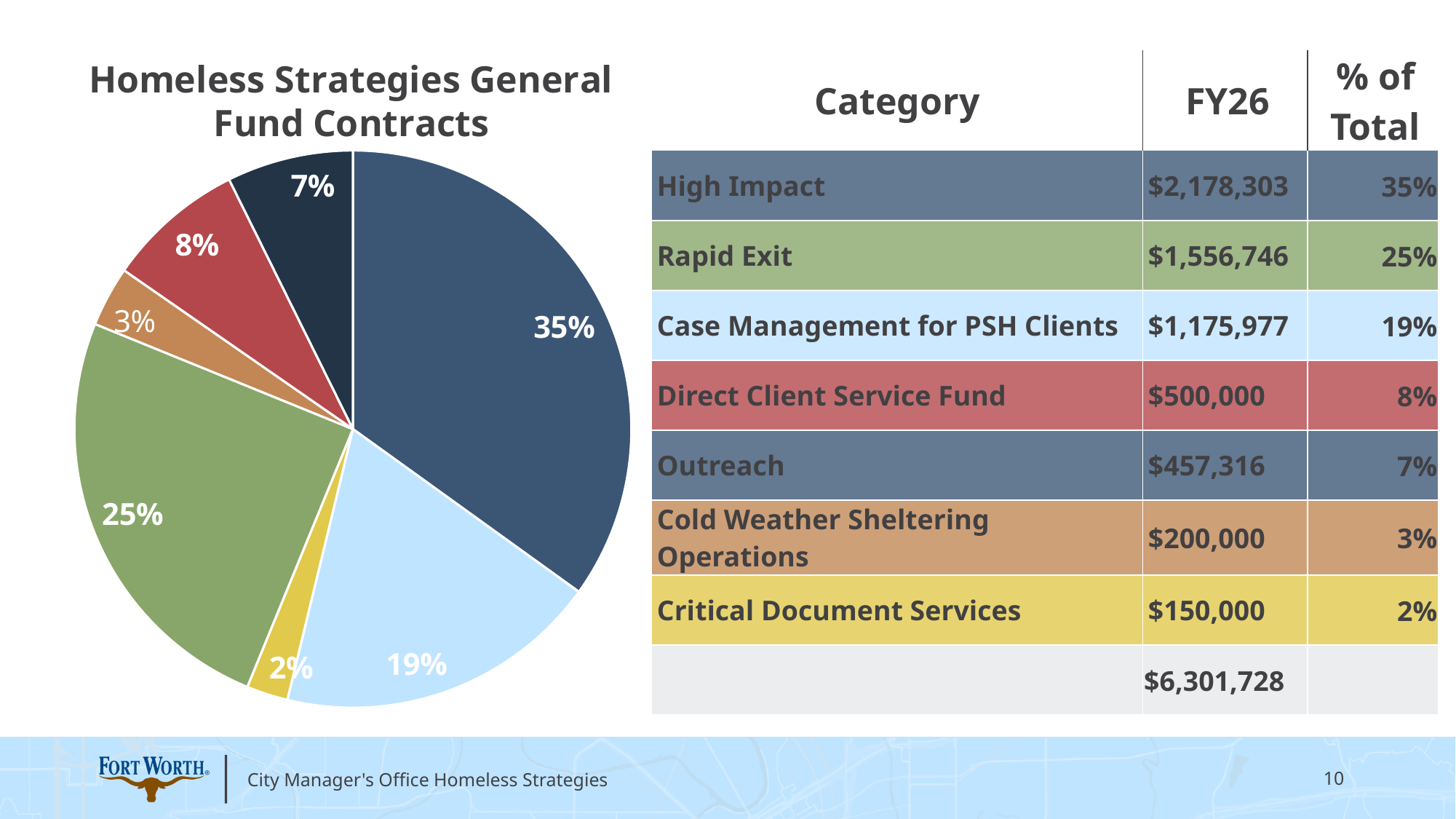
What is the difference in percentage points between the High Impact slice and the Rapid Exit slice? 10 What is the FY26 amount for Cold Weather Sheltering Operations? $200,000 What is the title of the pie chart? Homeless Strategies General Fund Contracts How many slices does the pie chart have? 7 Which category has the largest slice of the pie? High Impact Which slice is larger, Direct Client Service Fund or Outreach? Direct Client Service Fund What share of the pie does the smallest slice represent? 2% Which category has the smallest slice of the pie? Critical Document Services What percentage of the total is shown for Case Management for PSH Clients? 19% What share of the pie does the largest slice represent? 35% What kind of chart is shown on the slide? pie chart What percentage of the total is shown for Rapid Exit? 25%